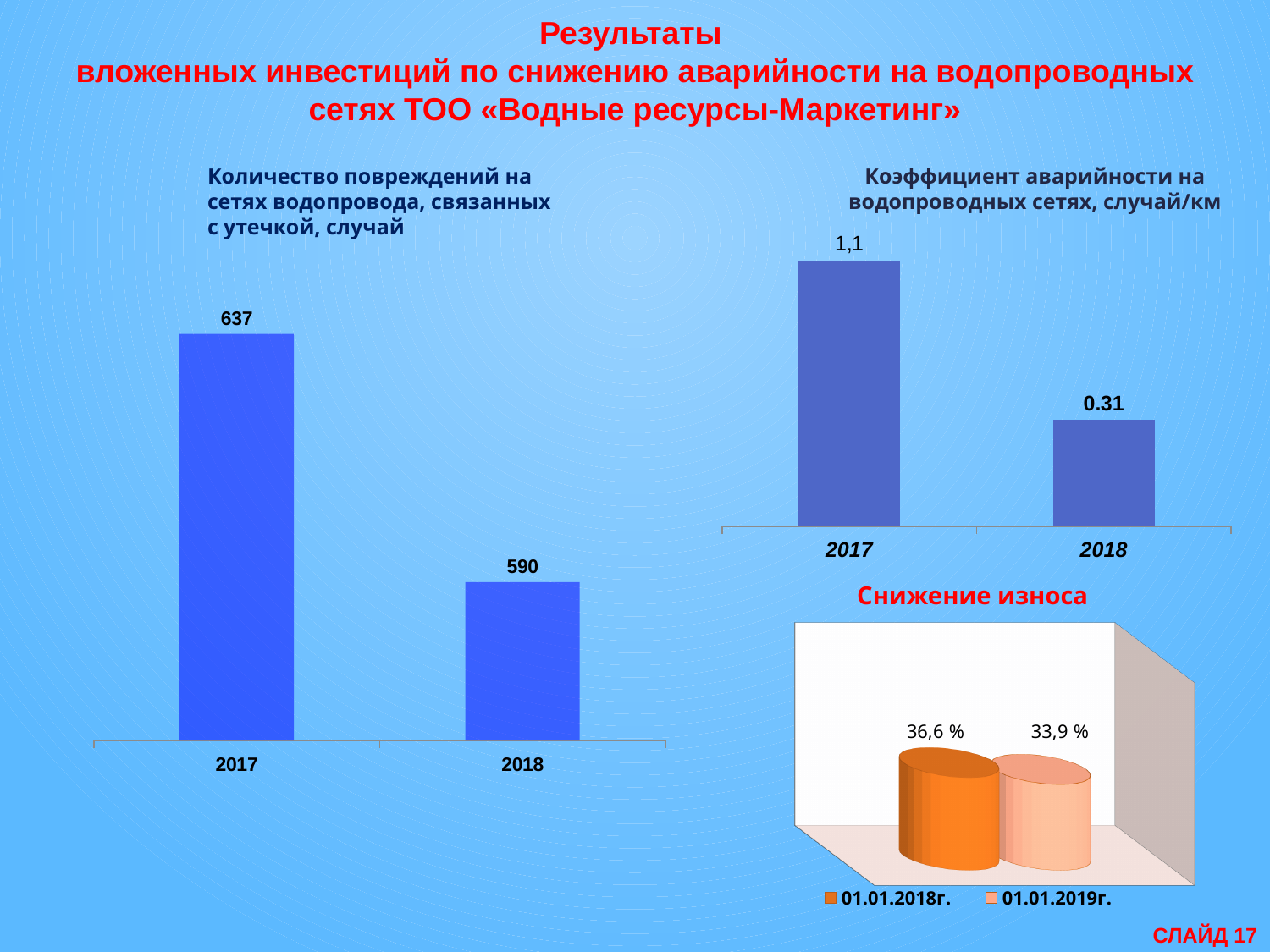
In the chart 'Снижение износа', how many entries does the legend list? 2 In the chart 'Коэффициент аварийности на водопроводных сетях, случай/км', do the values rise or fall from 2017 to 2018? fall In the chart 'Коэффициент аварийности на водопроводных сетях, случай/км', what is the value for 2018? 0.31 What kind of chart is 'Количество повреждений на сетях водопровода, связанных с утечкой, случай'? bar chart In the chart 'Снижение износа', what is the value for 01.01.2019г.? 33,9 % In the chart 'Количество повреждений на сетях водопровода, связанных с утечкой, случай', what is the value for 2017? 637 In the chart 'Коэффициент аварийности на водопроводных сетях, случай/км', what is the value for 2017? 1,1 In the chart 'Снижение износа', what is the value for 01.01.2018г.? 36,6 % In the chart 'Количество повреждений на сетях водопровода, связанных с утечкой, случай', what is the value for 2018? 590 In the chart 'Количество повреждений на сетях водопровода, связанных с утечкой, случай', which year has the higher value? 2017 In the chart 'Количество повреждений на сетях водопровода, связанных с утечкой, случай', what is the difference between the 2017 and 2018 values? 47 In the chart 'Коэффициент аварийности на водопроводных сетях, случай/км', which year has the lower value? 2018